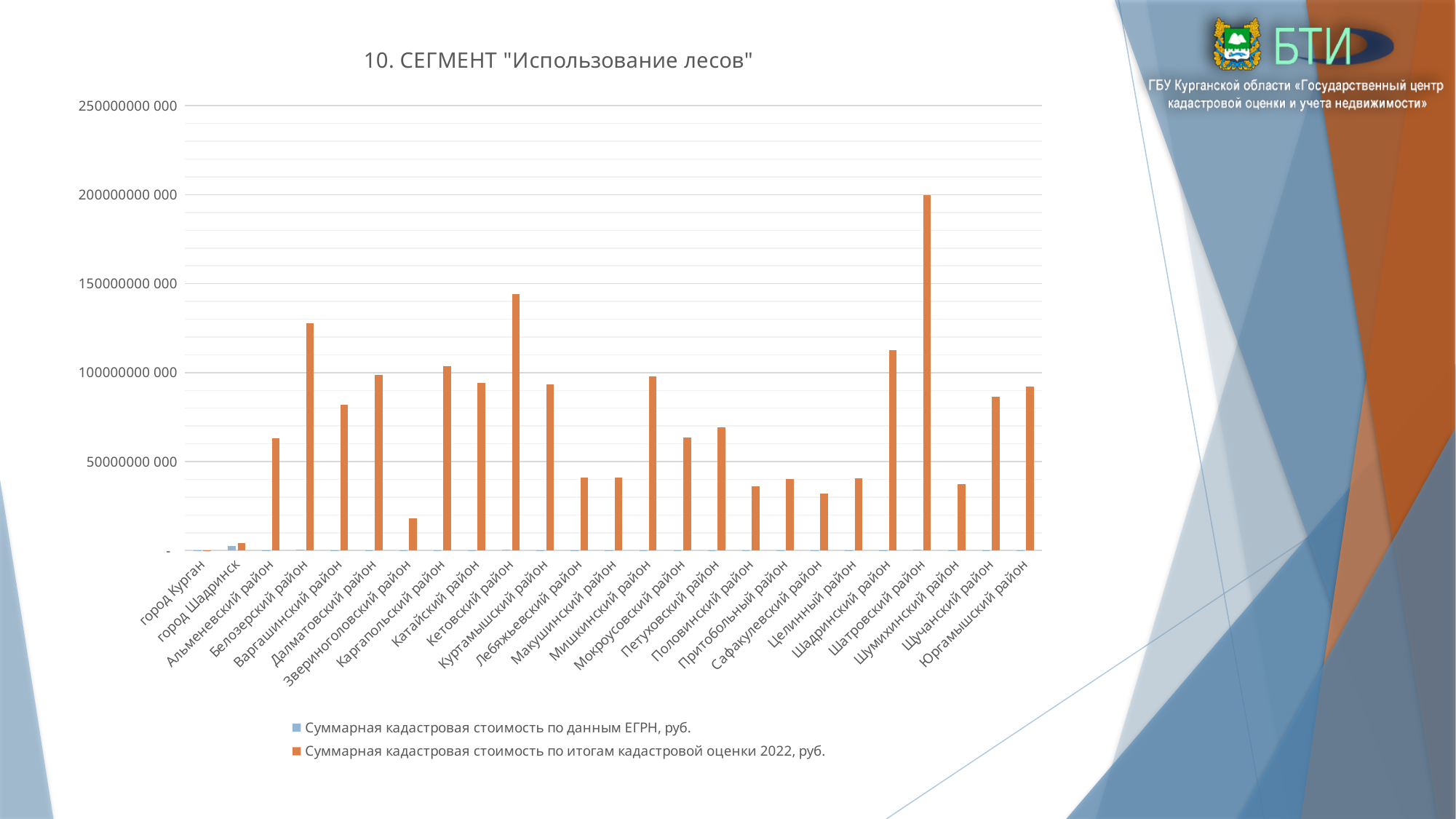
How many categories (districts and cities) are shown along the x axis? 25 What is the title of the chart? 10. СЕГМЕНТ "Использование лесов" What kind of chart is shown on the slide? bar chart Which category has the highest value for 'Суммарная кадастровая стоимость по итогам кадастровой оценки 2022, руб.'? Шатровский район Which has a larger 2022 assessment value: Белозерский район or Варгашинский район? Белозерский район Is the 2022 assessment value for Белозерский район greater or less than 100000000 000? greater Is the 2022 assessment value for Звериноголовский район greater or less than 50000000 000? less Which has a larger 2022 assessment value: Шадринский район or Щучанский район? Шадринский район Which colour represents the series 'Суммарная кадастровая стоимость по данным ЕГРН, руб.'? blue Is the 2022 assessment value for Кетовский район greater or less than 100000000 000? greater How many series does the legend list? 2